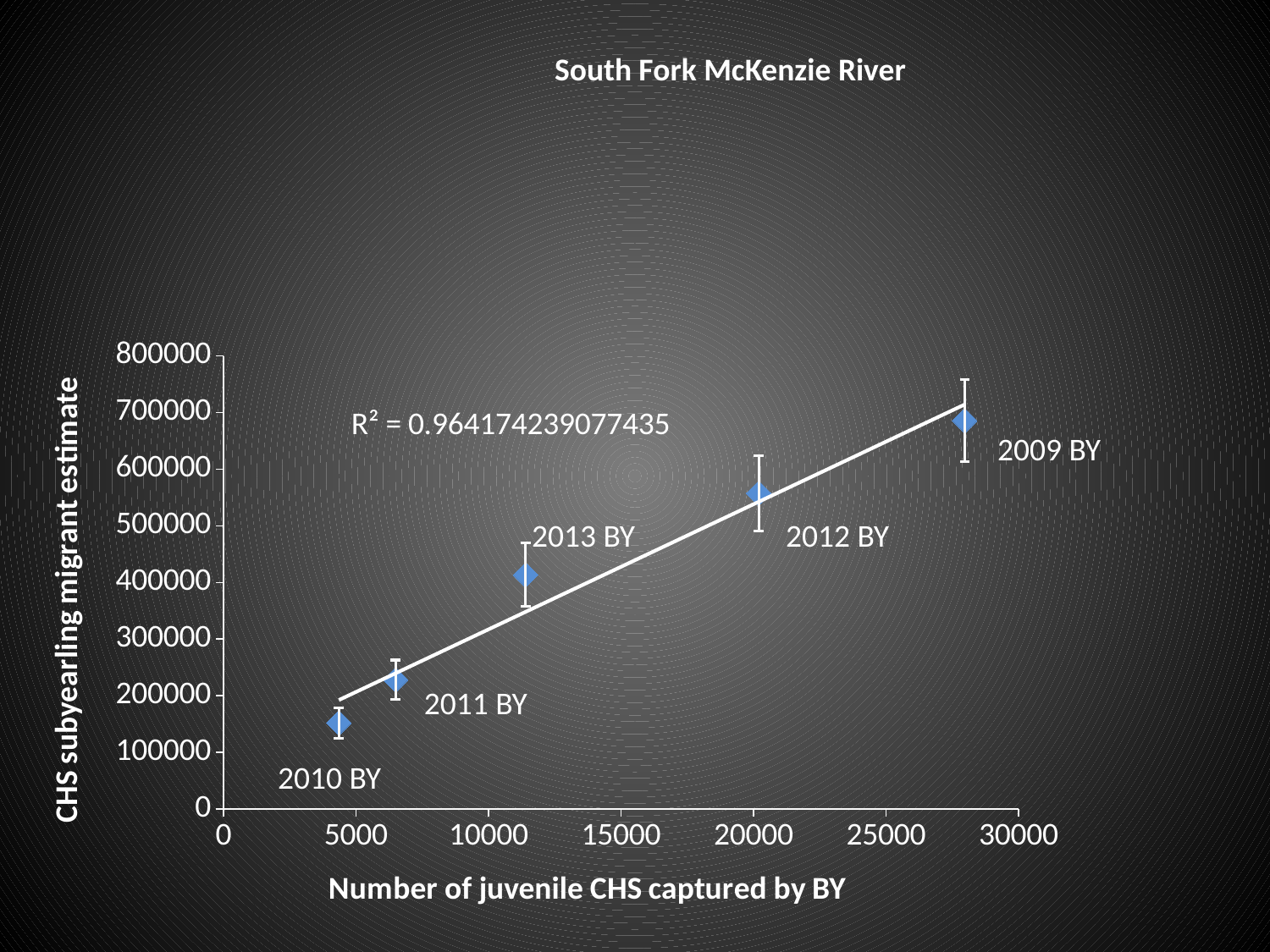
Which brood year has the highest CHS subyearling migrant estimate? 2009 BY Which has a larger CHS subyearling migrant estimate, 2012 BY or 2013 BY? 2012 BY As the number of juvenile CHS captured increases along the x axis, does the CHS subyearling migrant estimate rise or fall? Rise What is the title of the chart? South Fork McKenzie River How many data points are plotted on the chart? 5 Which has a larger number of juvenile CHS captured, 2011 BY or 2013 BY? 2013 BY Is the number of juvenile CHS captured for 2012 BY greater or less than 15000? greater Which brood year has the lowest CHS subyearling migrant estimate? 2010 BY Is the CHS subyearling migrant estimate for 2010 BY greater or less than 200000? less Is the CHS subyearling migrant estimate for 2009 BY greater or less than 600000? greater What kind of chart is shown on the slide? Scatter chart What R² value is printed on the chart? R² = 0.964174239077435